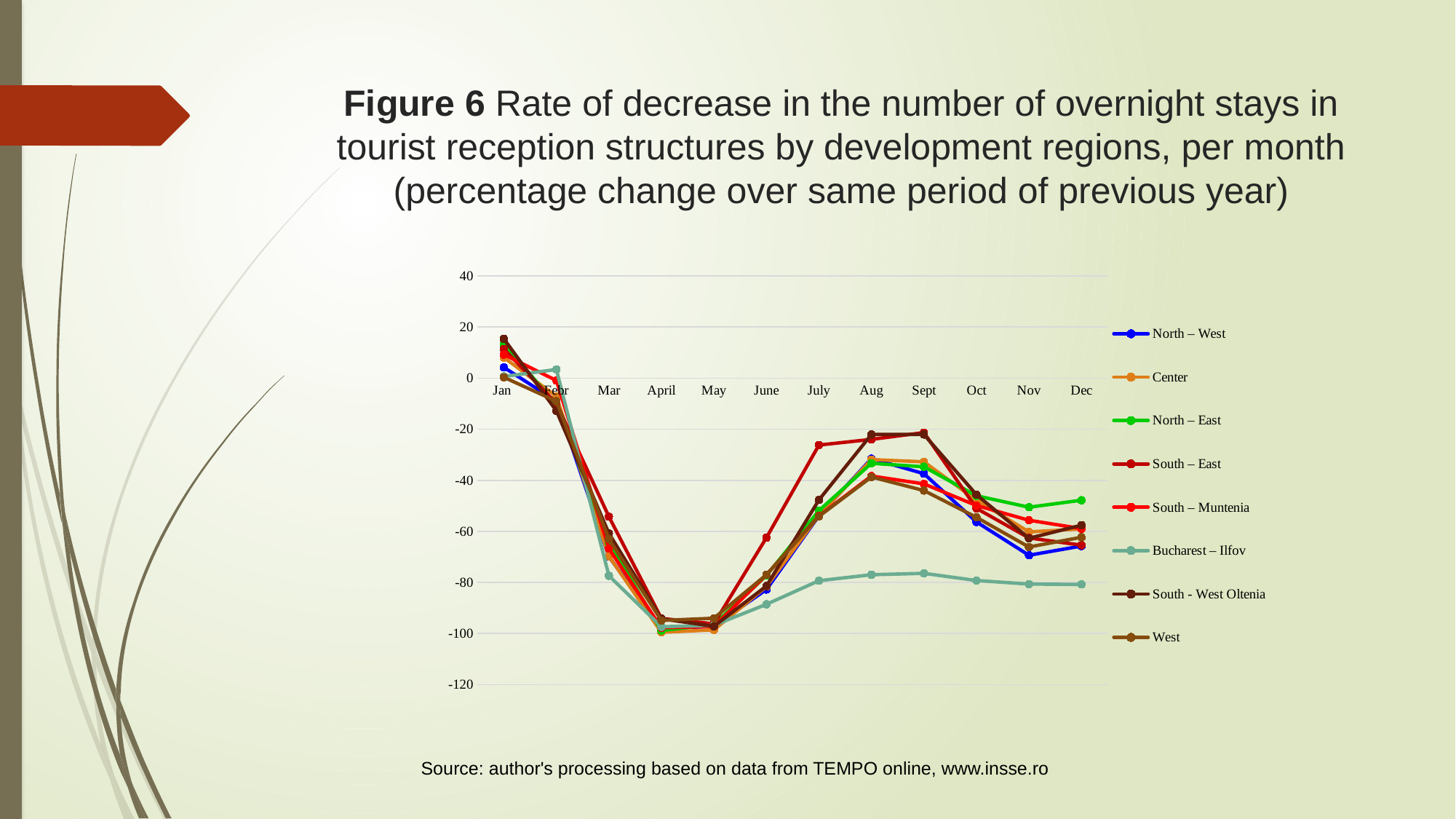
Is the value for South – East in July greater or less than -40? greater Is the value for Bucharest – Ilfov in Dec greater or less than -60? less Which is larger in Dec, the value for North – East or the value for Bucharest – Ilfov? North – East Which region has the lowest value in June? Bucharest – Ilfov Which region has the lowest value in Dec? Bucharest – Ilfov According to the note below the chart, what is the source of the data? Author's processing based on data from TEMPO online, www.insse.ro Do the values for Bucharest – Ilfov rise or fall from Jan to April? Fall What kind of chart is shown on the slide? Line chart Which region has the highest value in July? South – East Which region has the highest value in Dec? North – East How many series does the legend list? 8 How many months are plotted along the x axis? 12